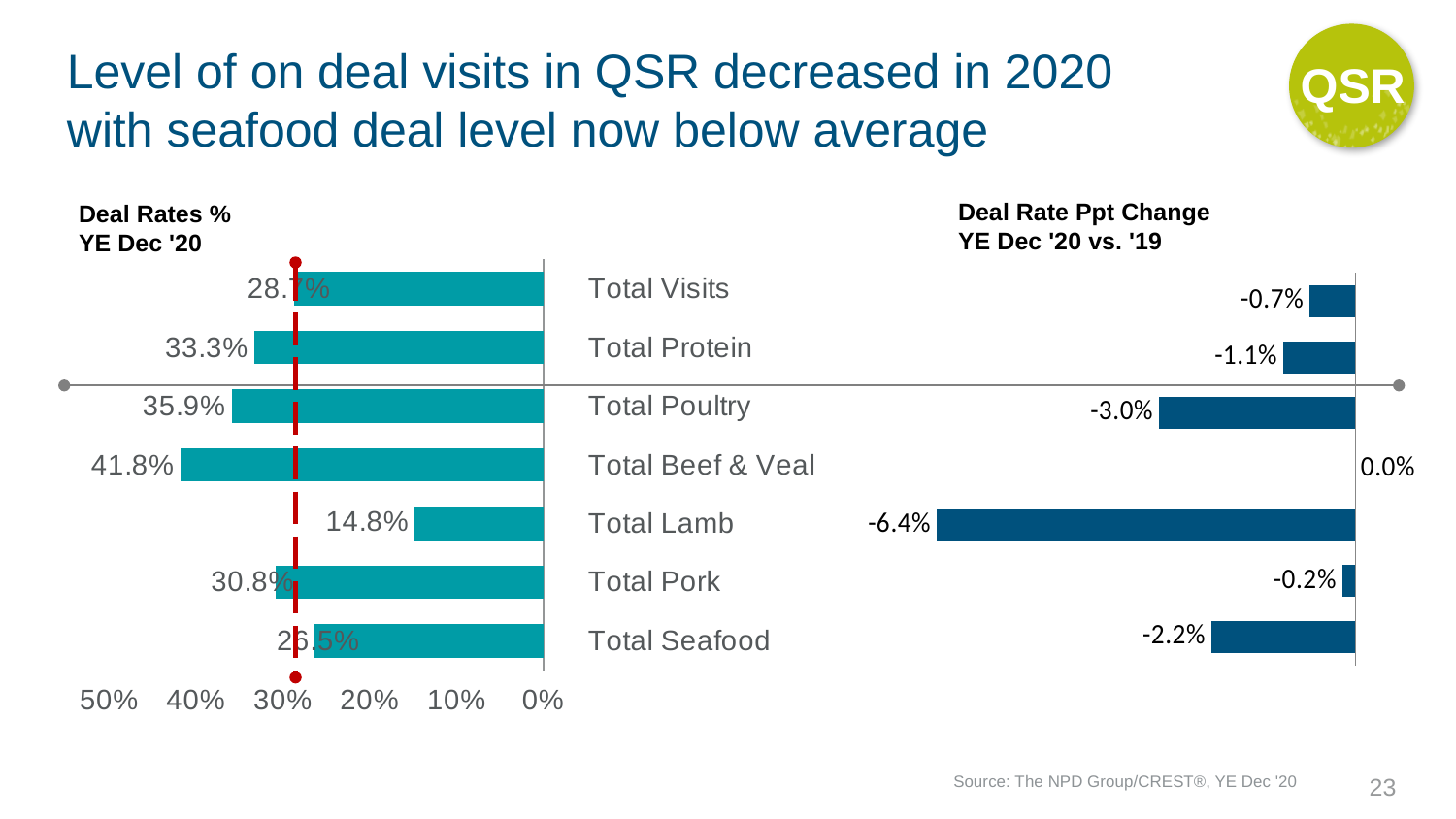
In the Deal Rates % YE Dec '20 chart, is the value for Total Seafood greater or less than 30%? less In the Deal Rate Ppt Change YE Dec '20 vs. '19 chart, which category shows the largest decrease? Total Lamb In the Deal Rate Ppt Change YE Dec '20 vs. '19 chart, which shows a larger decrease, Total Poultry or Total Protein? Total Poultry In the Deal Rates % YE Dec '20 chart, what is the deal rate for Total Lamb? 14.8% How many categories are shown in the Deal Rates % YE Dec '20 chart? 7 In the Deal Rates % YE Dec '20 chart, which category has the highest deal rate? Total Beef & Veal In the Deal Rates % YE Dec '20 chart, what is the deal rate for Total Poultry? 35.9% In the Deal Rates % YE Dec '20 chart, what is the deal rate for Total Beef & Veal? 41.8% In the Deal Rate Ppt Change YE Dec '20 vs. '19 chart, what is the change for Total Seafood? -2.2% In the Deal Rate Ppt Change YE Dec '20 vs. '19 chart, what is the change for Total Lamb? -6.4% In the Deal Rates % YE Dec '20 chart, which category has the lowest deal rate? Total Lamb In the Deal Rates % YE Dec '20 chart, how much higher is the deal rate for Total Beef & Veal than for Total Lamb? 27.0%